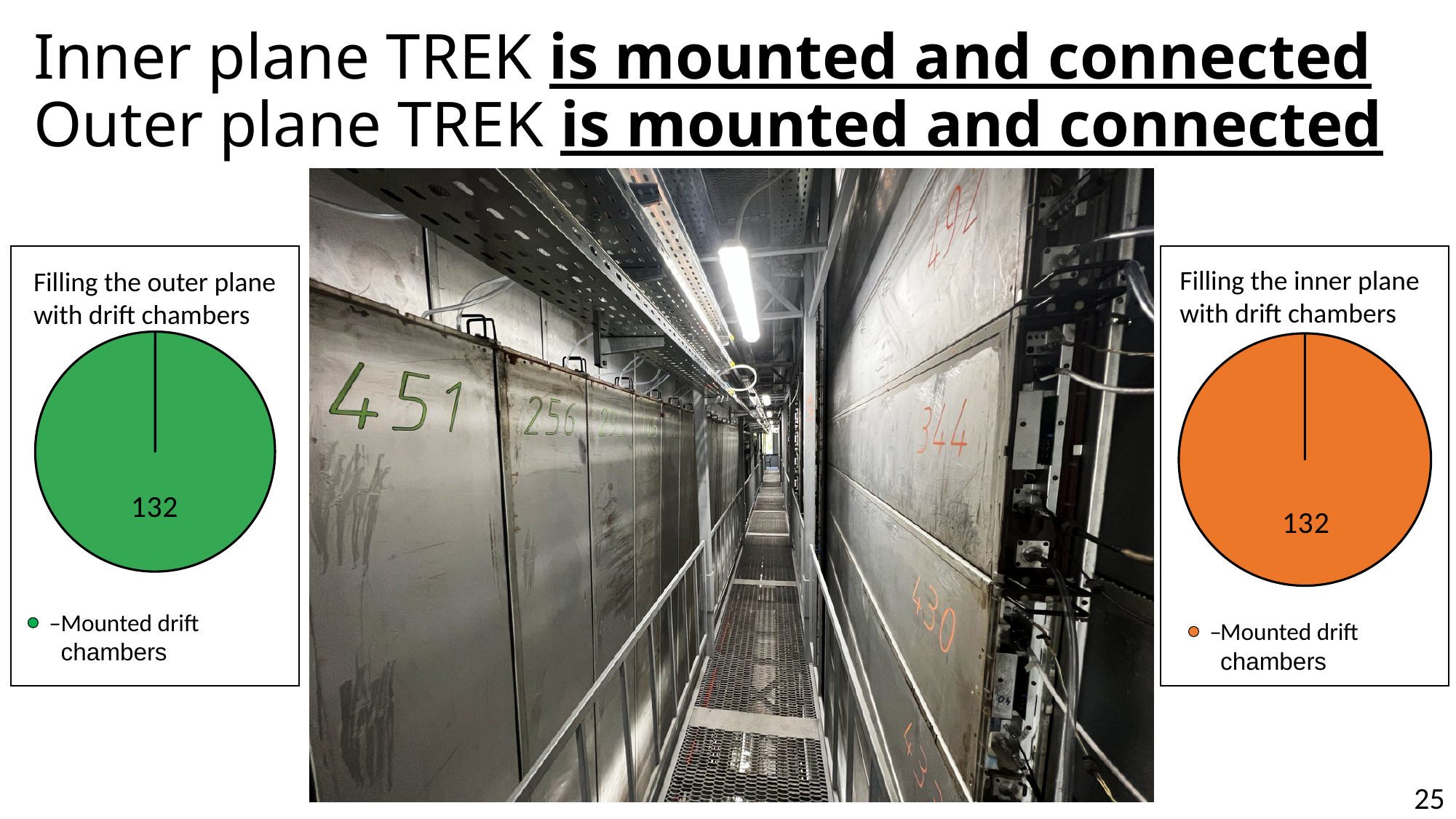
How many slices does the "Filling the outer plane with drift chambers" pie chart have? 1 What kind of chart is the "Filling the inner plane with drift chambers" chart on the right of the slide? Pie chart In the chart titled "Filling the inner plane with drift chambers", what is the value shown for mounted drift chambers? 132 Is the value for mounted drift chambers in the "Filling the outer plane with drift chambers" chart larger than, smaller than, or equal to the value in the "Filling the inner plane with drift chambers" chart? Equal How many series does the legend of the "Filling the inner plane with drift chambers" chart list? 1 What colour is the slice in the "Filling the outer plane with drift chambers" pie chart? Green In the chart titled "Filling the outer plane with drift chambers", what is the value shown for mounted drift chambers? 132 What is the difference between the mounted drift chambers value in the outer plane chart and the inner plane chart? 0 What kind of chart is the "Filling the outer plane with drift chambers" chart on the left of the slide? Pie chart How many slices does the "Filling the inner plane with drift chambers" pie chart have? 1 What is the legend entry in the "Filling the inner plane with drift chambers" chart? –Mounted drift chambers How many series does the legend of the "Filling the outer plane with drift chambers" chart list? 1